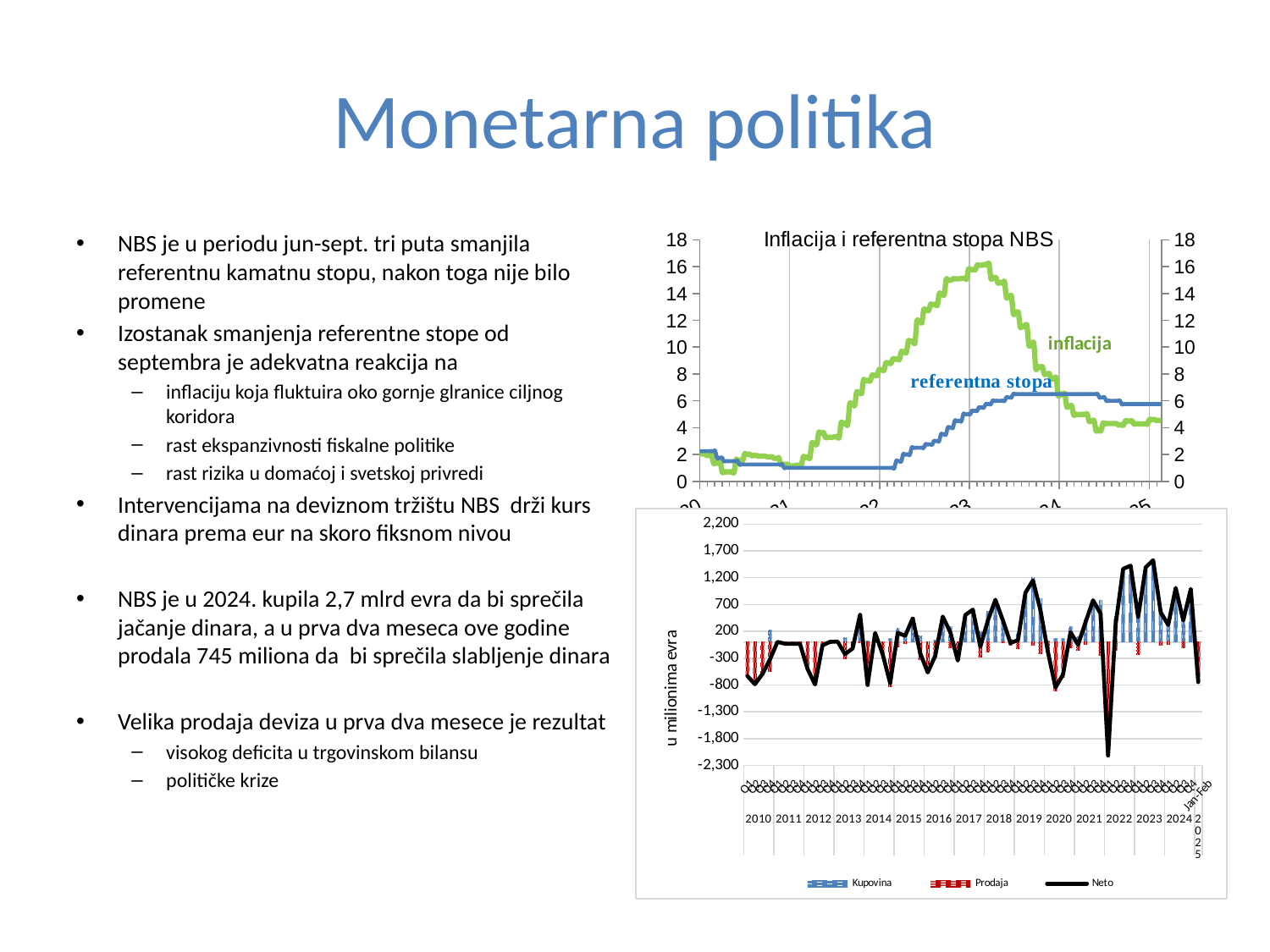
In the top chart 'Inflacija i referentna stopa NBS', which series reaches the higher peak, inflacija or referentna stopa? inflacija In the top chart 'Inflacija i referentna stopa NBS', is the peak value of inflacija greater or less than 14? greater In the top chart 'Inflacija i referentna stopa NBS', how many series are plotted? 2 In the bottom chart, is the lowest value of the Neto line (in 2022) greater or less than -1,800? less In the bottom chart, is the highest value of the Neto line (in 2023) greater or less than 1,200? greater In the bottom chart, how many series does the legend list? 3 What is the title of the top chart? Inflacija i referentna stopa NBS In the bottom chart, what is the label of the y axis? u milionima evra In the top chart 'Inflacija i referentna stopa NBS', does inflacija rise or fall between 2022 and its peak in 2023? rise In the top chart 'Inflacija i referentna stopa NBS', what is the maximum value shown on the y axis? 18 In the top chart 'Inflacija i referentna stopa NBS', what type of chart is used? line chart